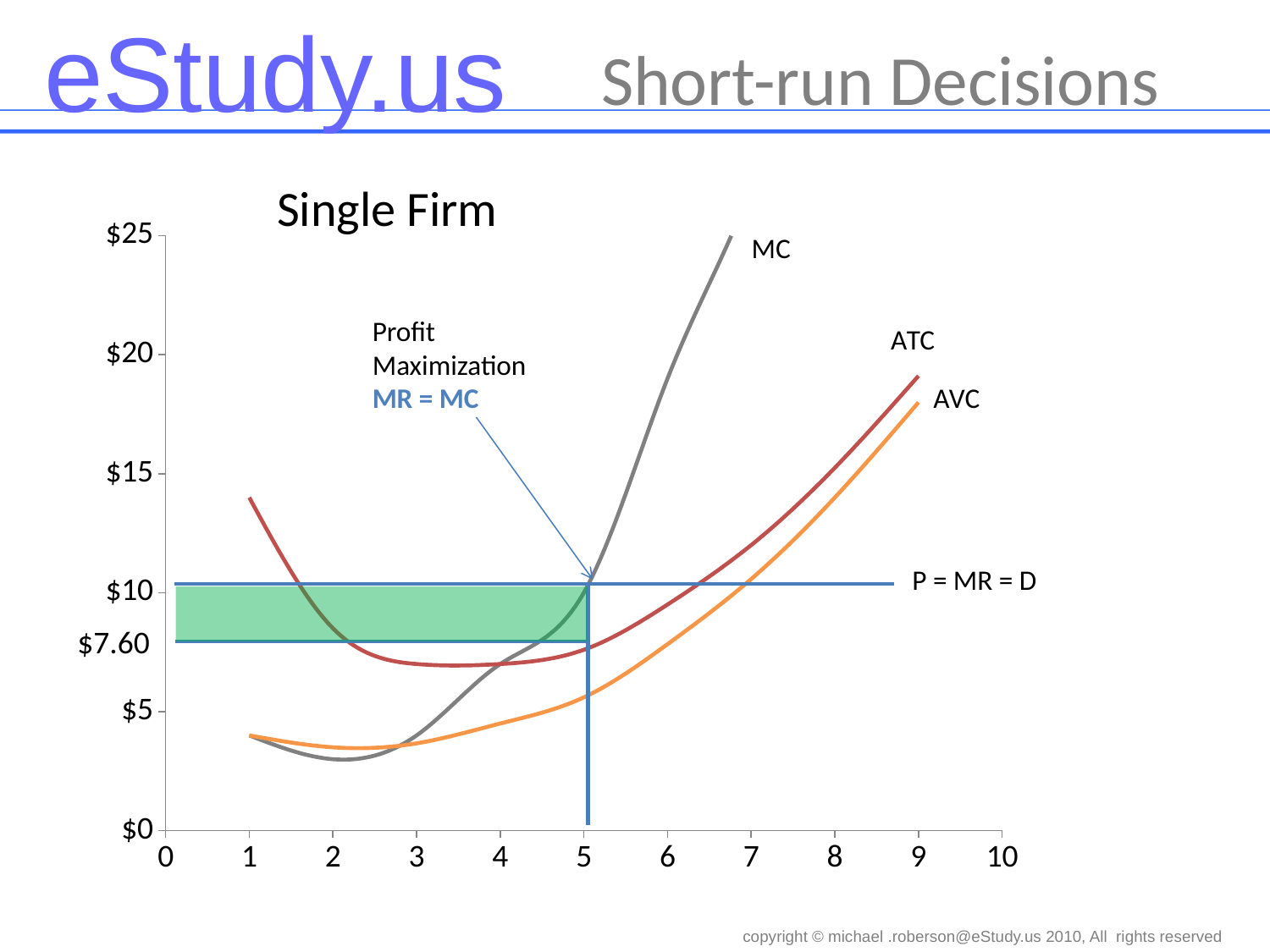
What is the title of the chart? Single Firm How many labeled curves or lines are plotted on the chart? 4 Is the value of AVC at a quantity of 5 greater or less than $10? less What is the value of ATC at a quantity of 5, as labeled on the y-axis? $7.60 Which curve reaches the highest value on the chart? MC Is the value of MC at a quantity of 6 greater or less than $15? greater Does the MC curve rise or fall between quantities 3 and 7? rise What kind of chart is shown on the slide? line chart At a quantity of 7, which is higher, ATC or AVC? ATC Which curve is lowest at a quantity of 4? AVC At what quantity does the chart mark profit maximization (MR = MC)? 5 What label is given to the horizontal line at about $10? P = MR = D